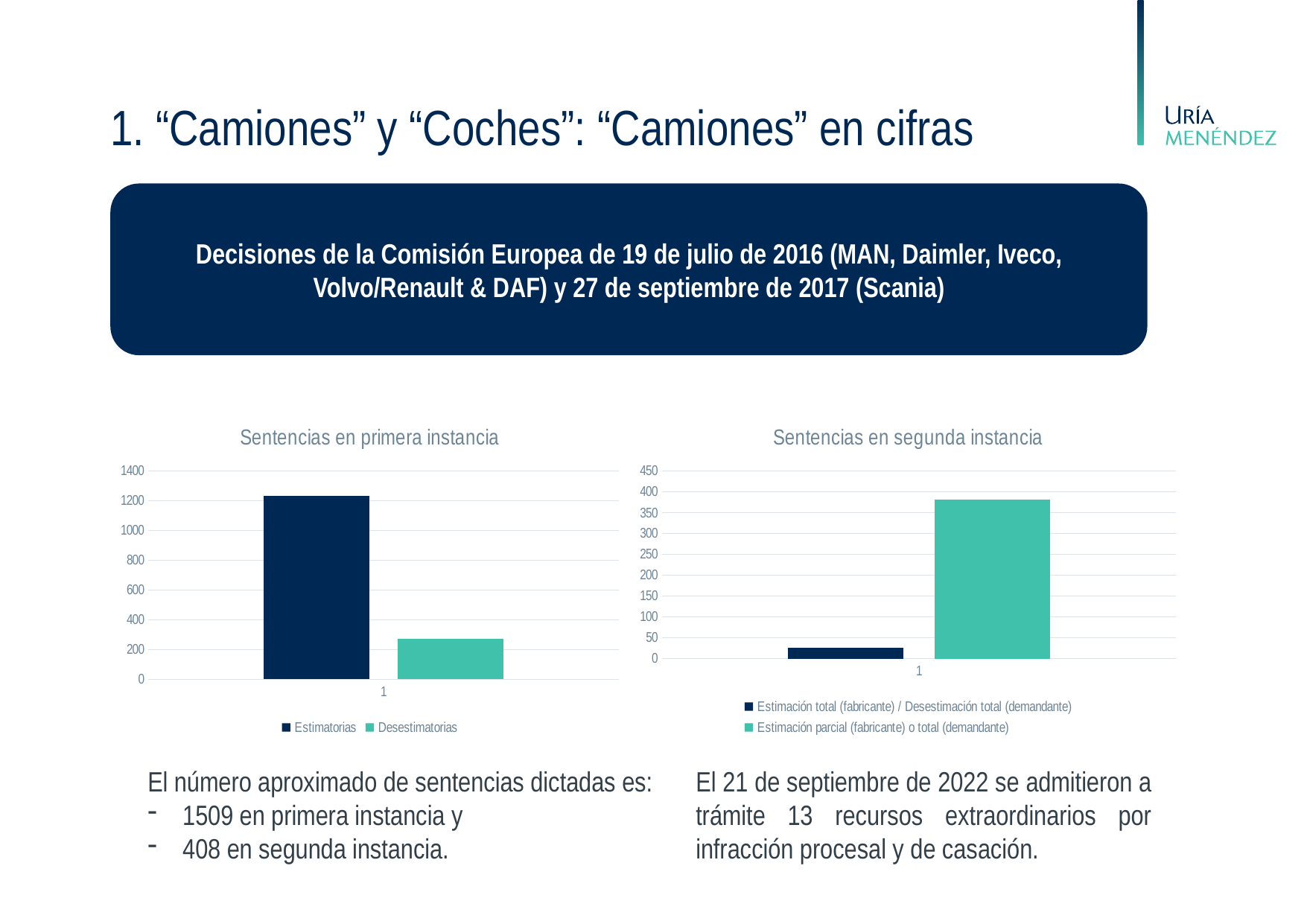
In the "Sentencias en primera instancia" chart, how many series does the legend list? 2 In the "Sentencias en segunda instancia" chart, is the value for "Estimación parcial (fabricante) o total (demandante)" greater or less than 350? greater What kind of chart is "Sentencias en primera instancia"? bar chart In the "Sentencias en segunda instancia" chart, how many series does the legend list? 2 In the "Sentencias en segunda instancia" chart, which series has the lowest value? Estimación total (fabricante) / Desestimación total (demandante) In the "Sentencias en primera instancia" chart, which series has the higher value, Estimatorias or Desestimatorias? Estimatorias In the "Sentencias en segunda instancia" chart, is the value for "Estimación total (fabricante) / Desestimación total (demandante)" greater or less than 50? less In the "Sentencias en primera instancia" chart, is the value for Desestimatorias greater or less than 400? less In the "Sentencias en segunda instancia" chart, what colour is the bar for "Estimación parcial (fabricante) o total (demandante)"? teal In the "Sentencias en primera instancia" chart, what is the highest value shown on the vertical axis? 1400 What kind of chart is "Sentencias en segunda instancia"? bar chart